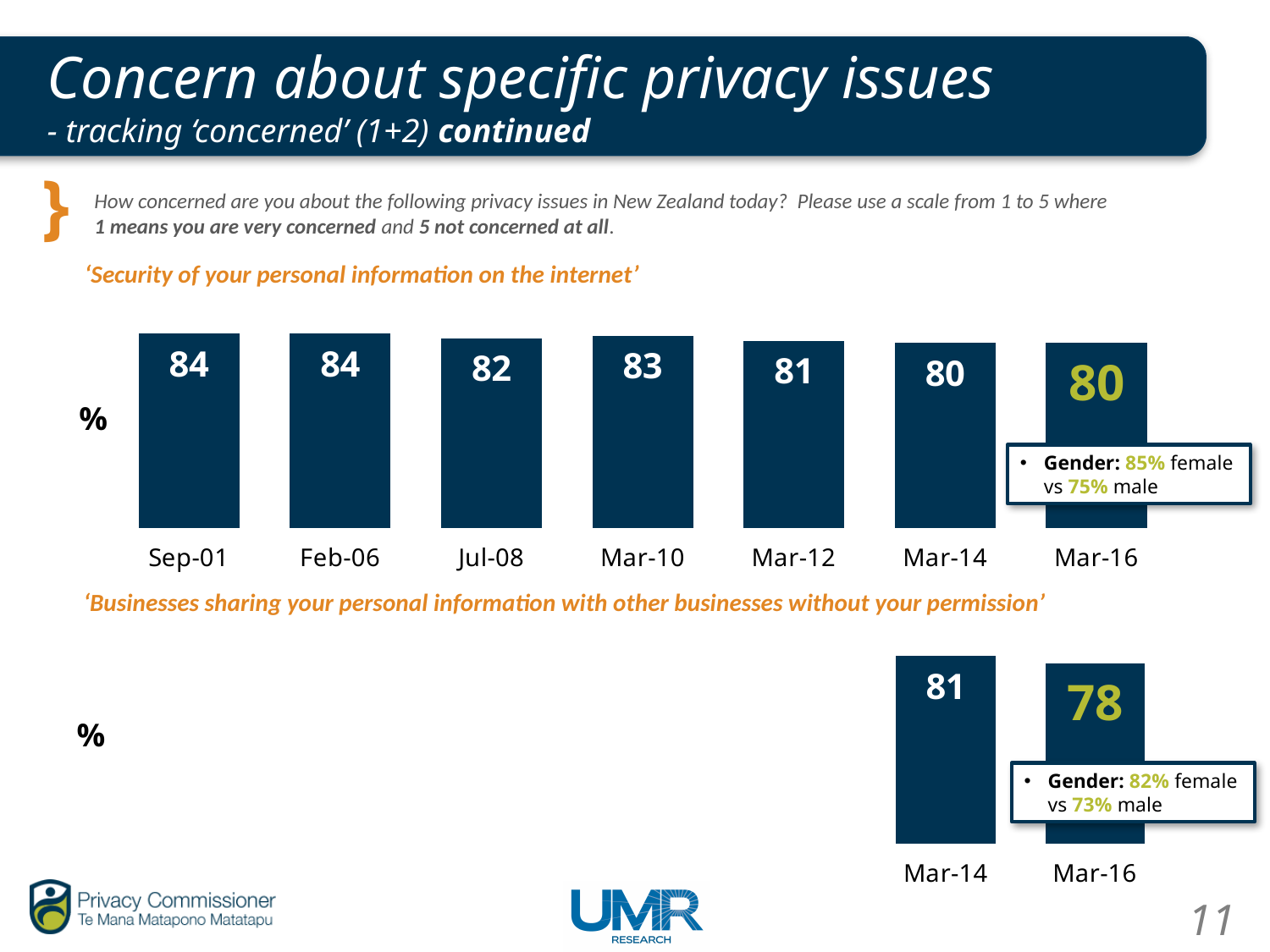
In the 'Security of your personal information on the internet' chart, what is the value for Mar-16? 80 What kind of chart is used for 'Security of your personal information on the internet'? bar chart In the 'Security of your personal information on the internet' chart, do the values generally rise or fall from Sep-01 to Mar-16? fall In the 'Businesses sharing your personal information with other businesses without your permission' chart, what is the value for Mar-16? 78 In the 'Security of your personal information on the internet' chart, what is the value for Mar-12? 81 In the 'Businesses sharing your personal information with other businesses without your permission' chart, what is the value for Mar-14? 81 In the 'Security of your personal information on the internet' chart, what is the value for Sep-01? 84 In the 'Security of your personal information on the internet' chart, how many time points are plotted? 7 In the 'Security of your personal information on the internet' chart, what is the difference between the Sep-01 value and the Mar-16 value? 4 In the 'Security of your personal information on the internet' chart, which is larger, the value for Jul-08 or the value for Mar-10? Mar-10 In the 'Businesses sharing your personal information with other businesses without your permission' chart, what is the difference between the Mar-14 and Mar-16 values? 3 In the 'Businesses sharing your personal information with other businesses without your permission' chart, which time point has the lowest value? Mar-16